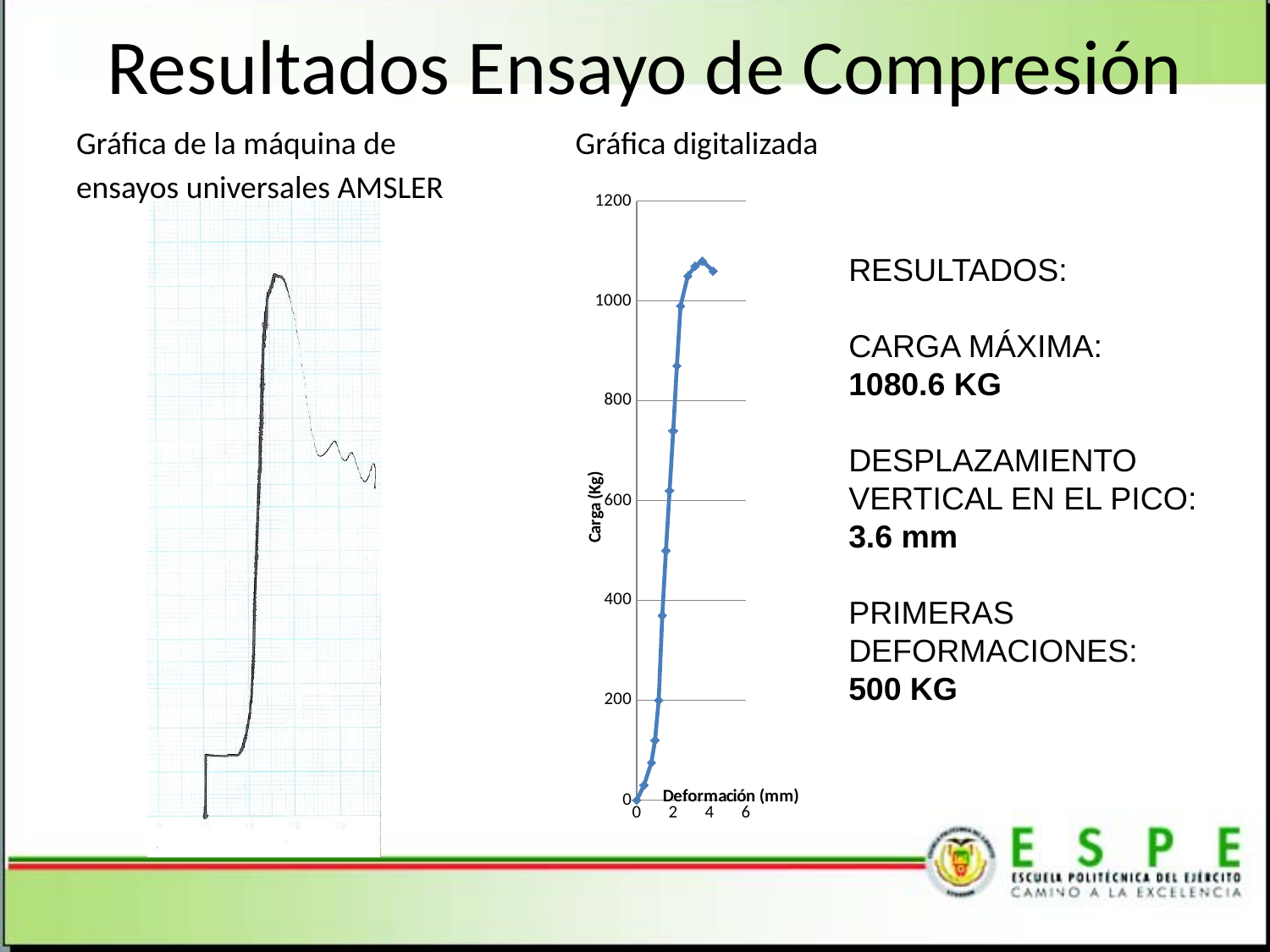
How many data series are plotted in the 'Gráfica digitalizada' chart? 1 In the 'Gráfica digitalizada' chart, is the peak load value greater or less than 1200? less In the 'Gráfica digitalizada' chart, is the load at a deformation of 1 mm greater or less than 600? less What kind of chart is the 'Gráfica digitalizada'? line chart In the 'Gráfica digitalizada' chart, does the load rise or fall as deformation increases from 0 mm to about 3 mm? rises In the 'Gráfica digitalizada' chart, is the peak load value greater or less than 1000? greater In the 'Gráfica digitalizada' chart, what is the title of the vertical axis? Carga (Kg) In the 'Gráfica digitalizada' chart, does the load rise or fall after the peak as deformation continues to increase? falls In the 'Gráfica digitalizada' chart, what is the title of the horizontal axis? Deformación (mm)